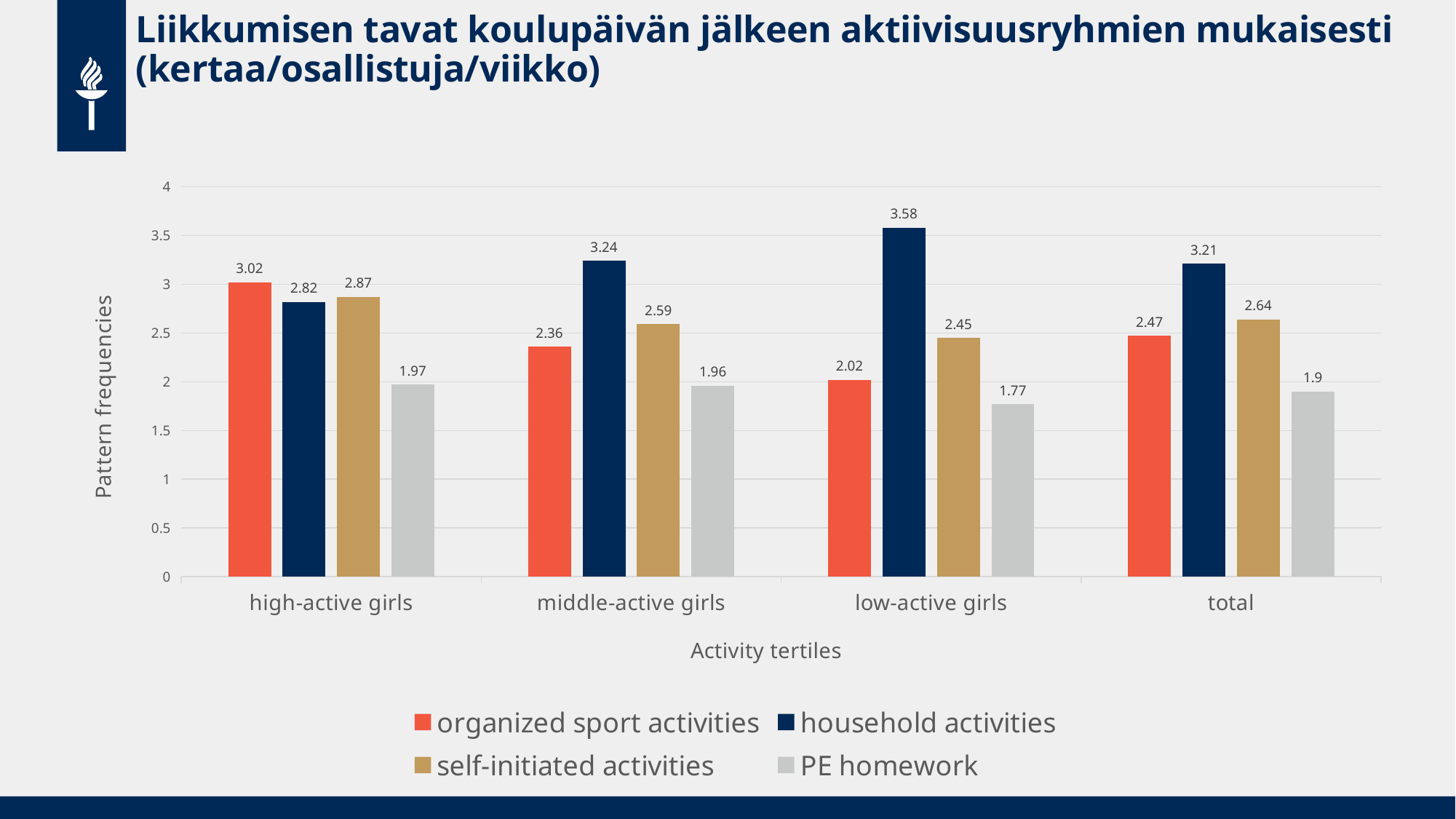
Which activity tertile has the highest value for household activities? low-active girls What is the value for household activities among low-active girls? 3.58 Which is larger for high-active girls: organized sport activities or household activities? organized sport activities What is the value for PE homework in the total group? 1.9 What is the value for organized sport activities among middle-active girls? 2.36 What is the difference between household activities and organized sport activities among low-active girls? 1.56 How many series does the legend list? 4 What kind of chart is shown on the slide? bar chart Is the value for self-initiated activities among high-active girls greater or less than 2.5? greater Do the values for organized sport activities rise or fall from high-active girls to low-active girls? fall Which activity tertile has the lowest value for PE homework? low-active girls How many activity tertile categories are shown on the x axis? 4